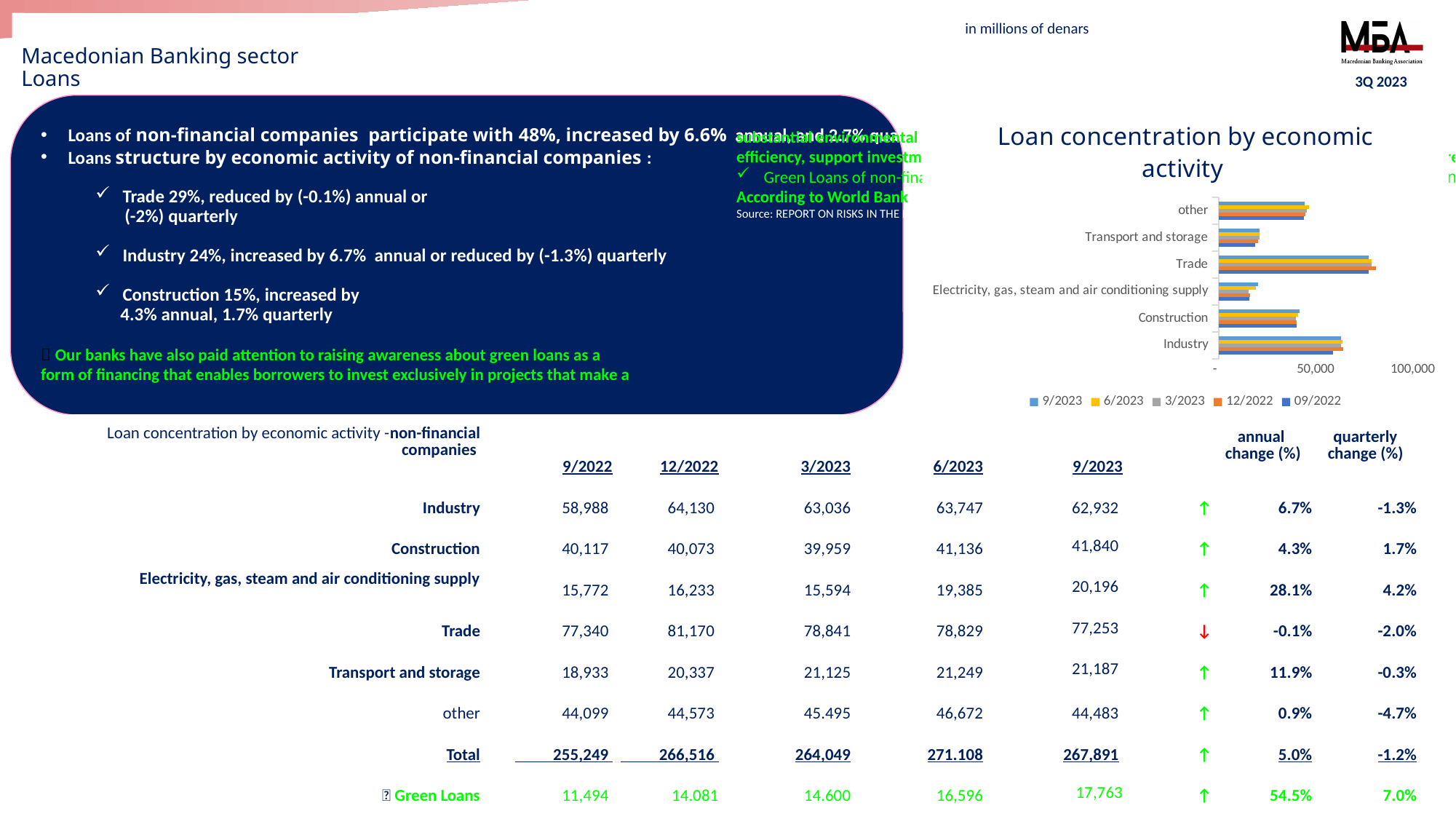
In the 'Loan concentration by economic activity' chart, which economic activity has the longest bars? Trade In the 'Loan concentration by economic activity' chart, which is larger for 9/2023: Industry or Construction? Industry In the 'Loan concentration by economic activity' chart, which economic activity has the shortest bar for 3/2023? Electricity, gas, steam and air conditioning supply What is the 9/2023 value for Trade plotted in the 'Loan concentration by economic activity' chart, as printed in the table on the slide? 77,253 In the 'Loan concentration by economic activity' chart, is the 9/2023 value for Construction greater or less than 50,000? less How many series does the legend of the 'Loan concentration by economic activity' chart list? 5 What type of chart is 'Loan concentration by economic activity'? bar chart How many economic activity categories are shown in the 'Loan concentration by economic activity' chart? 6 In the 'Loan concentration by economic activity' chart, which is larger for 9/2023: Trade or other? Trade Which series is listed first in the legend of the 'Loan concentration by economic activity' chart? 9/2023 In the 'Loan concentration by economic activity' chart, is the 9/2023 value for Industry greater or less than 50,000? greater In the 'Loan concentration by economic activity' chart, is the 9/2023 value for Trade greater or less than 50,000? greater